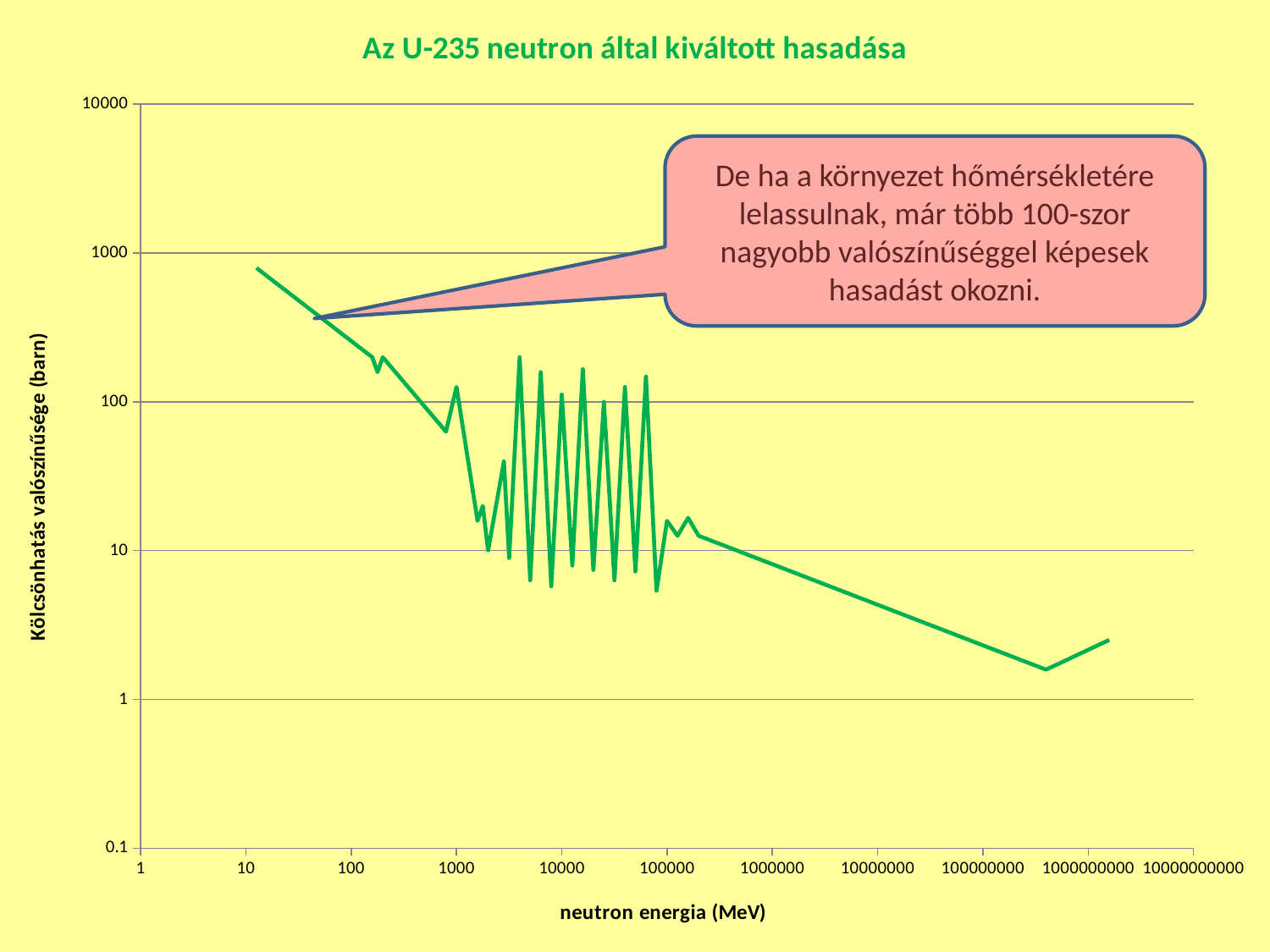
What kind of chart is shown on the slide? line chart What is the label of the x axis of the chart? neutron energia (MeV) Is the highest value reached by the curve greater or less than 1000? less What is the title of the chart? Az U-235 neutron által kiváltott hasadása Is the value of the curve at a neutron energy of 100 MeV greater or less than 100? greater Is the value of the curve at a neutron energy of 100000000 MeV greater or less than 1? greater Overall, does the curve rise or fall as neutron energy increases along the x axis? fall Which is larger: the value of the curve at 100 MeV or at 1000000 MeV? 100 MeV